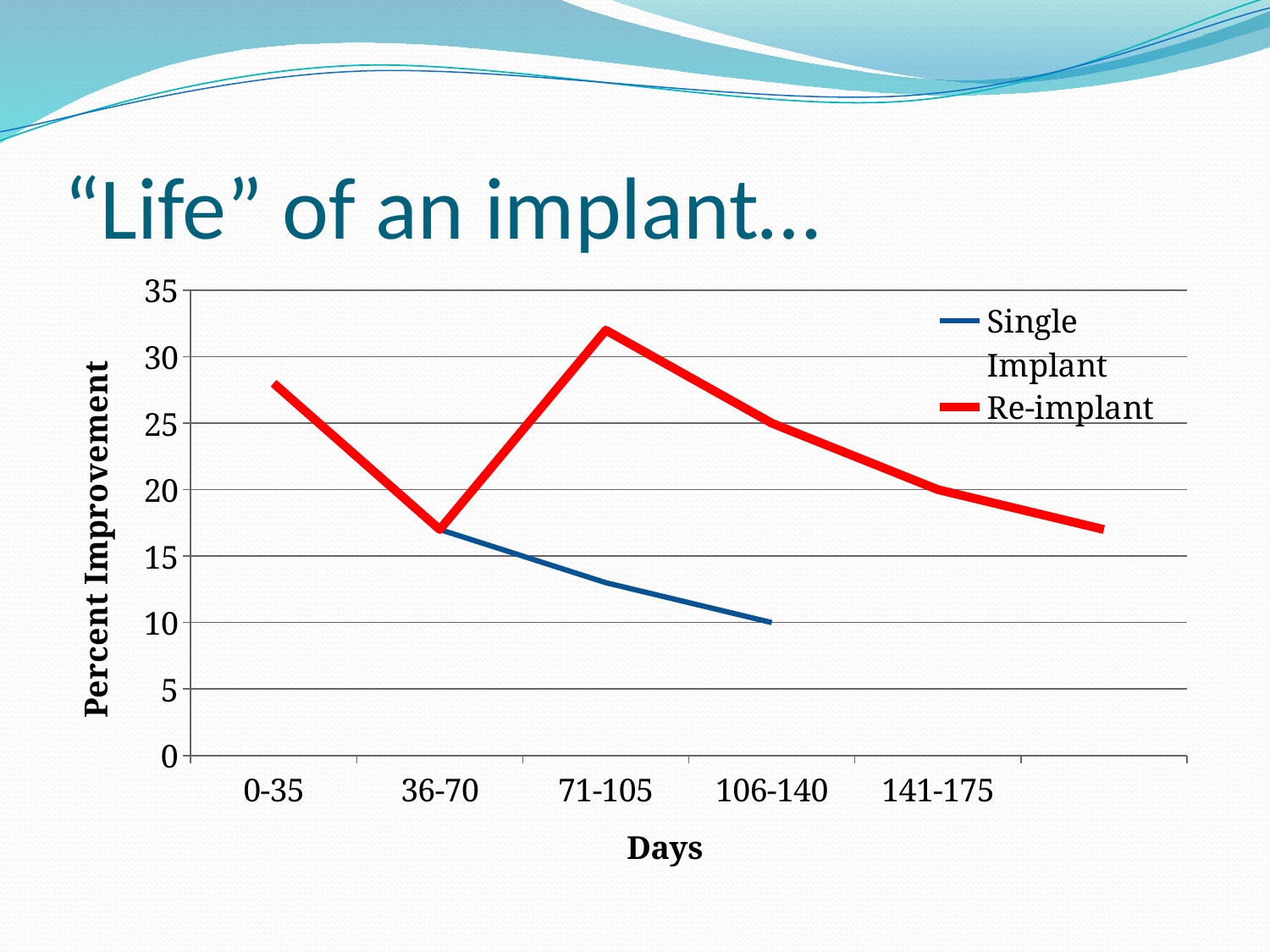
Does the Single Implant series rise or fall from 36-70 days to 106-140 days? fall What kind of chart is shown on the slide? line chart Is the Re-implant value for 71-105 days greater or less than 30? greater What is the title of the vertical axis? Percent Improvement Is the Re-implant value for 0-35 days greater or less than 25? greater What is the Single Implant value at 106-140 days? 10 At 71-105 days, which series has the larger value, Single Implant or Re-implant? Re-implant Is the Single Implant value for 71-105 days greater or less than 15? less How many series does the legend list? 2 At which day range does the Single Implant series reach its lowest value? 106-140 What are the two series named in the legend? Single Implant and Re-implant At which day range does the Re-implant series reach its highest value? 71-105